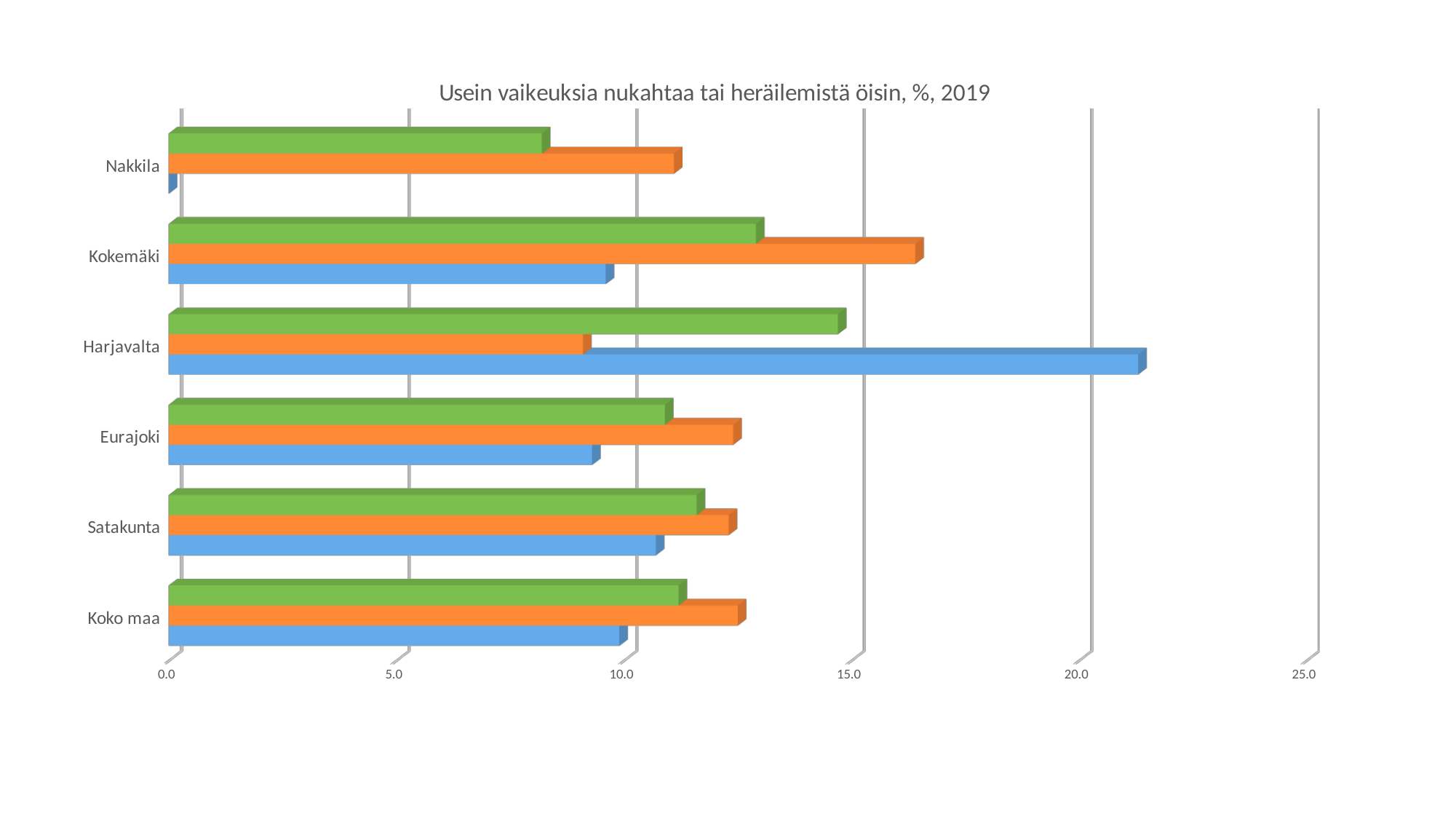
Is the blue bar for Harjavalta greater or less than 20.0? greater Is the orange bar for Kokemäki greater or less than 15.0? greater How many categories are shown on the vertical axis of the chart? 6 What kind of chart is shown on the slide? bar chart Which category has the shortest blue bar? Nakkila Which category has the longest blue bar? Harjavalta Which category has the longest orange bar? Kokemäki For Harjavalta, which is larger: the blue bar or the orange bar? the blue bar What is the title of the chart? Usein vaikeuksia nukahtaa tai heräilemistä öisin, %, 2019 Is the green bar for Nakkila greater or less than 10.0? less How many bars are plotted for each category in the chart? 3 For Kokemäki, which is larger: the orange bar or the green bar? the orange bar